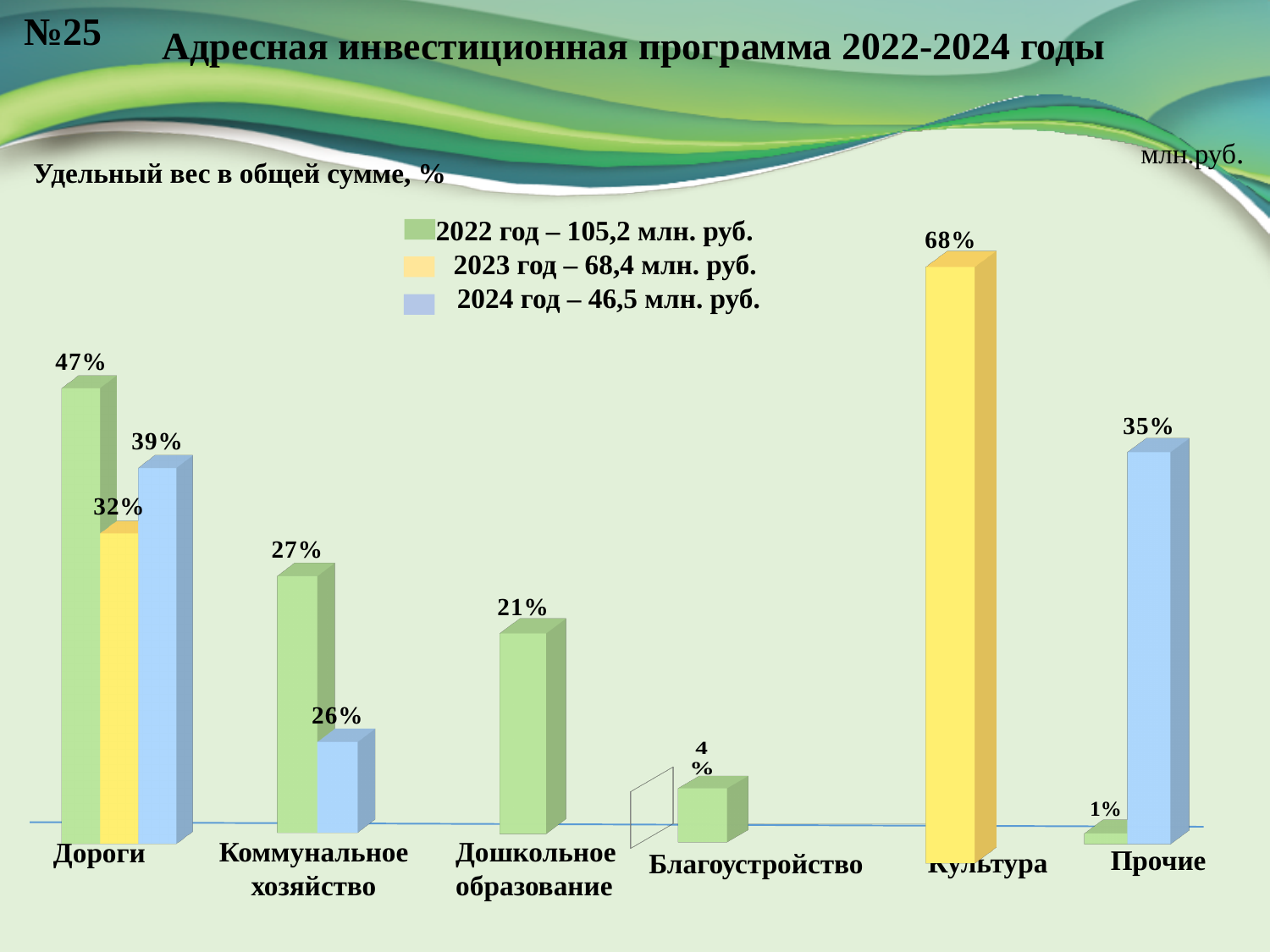
What is the 2024 share for Прочие? 35% Which is larger for Дороги: the 2024 share or the 2023 share? 2024 share What is the 2023 share for Культура? 68% How many categories are shown on the x axis? 6 What is the 2022 share for Дороги? 47% What is the 2024 share for Коммунальное хозяйство? 26% Which category has the lowest 2022 share? Прочие How many series does the legend list? 3 According to the legend, what is the total amount for 2023? 68,4 млн. руб. What is the difference between the 2022 and 2023 shares for Дороги? 15% Which category has the highest 2022 share? Дороги What kind of chart is shown on the slide? bar chart